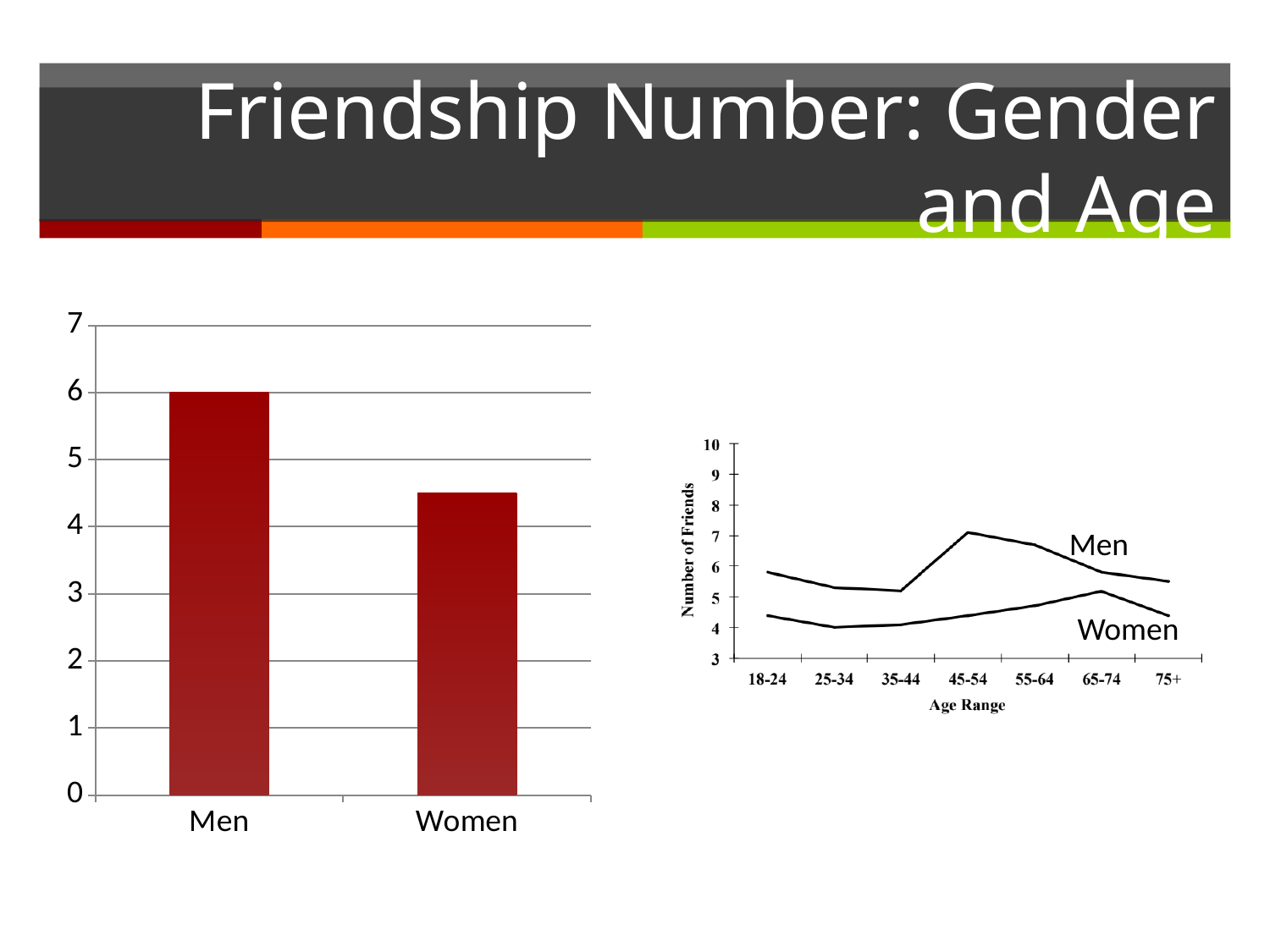
On the left bar chart, is the value for Women greater or less than 5? less On the left bar chart, which category has the higher value? Men On the right line chart, how many series are plotted? 2 On the right line chart, at the 45-54 age range, which line is higher, Men or Women? Men On the right line chart, how many age ranges are shown on the x axis? 7 On the left bar chart, how many categories are shown? 2 On the left bar chart, is the value for Women greater or less than 4? greater What kind of chart is the chart on the left of the slide? bar chart What kind of chart is the chart on the right of the slide? line chart On the left bar chart, what is the value for Men? 6 On the right line chart, is the value for Men at 55-64 greater or less than 6? greater On the right line chart, at which age range does the Men line reach its highest value? 45-54